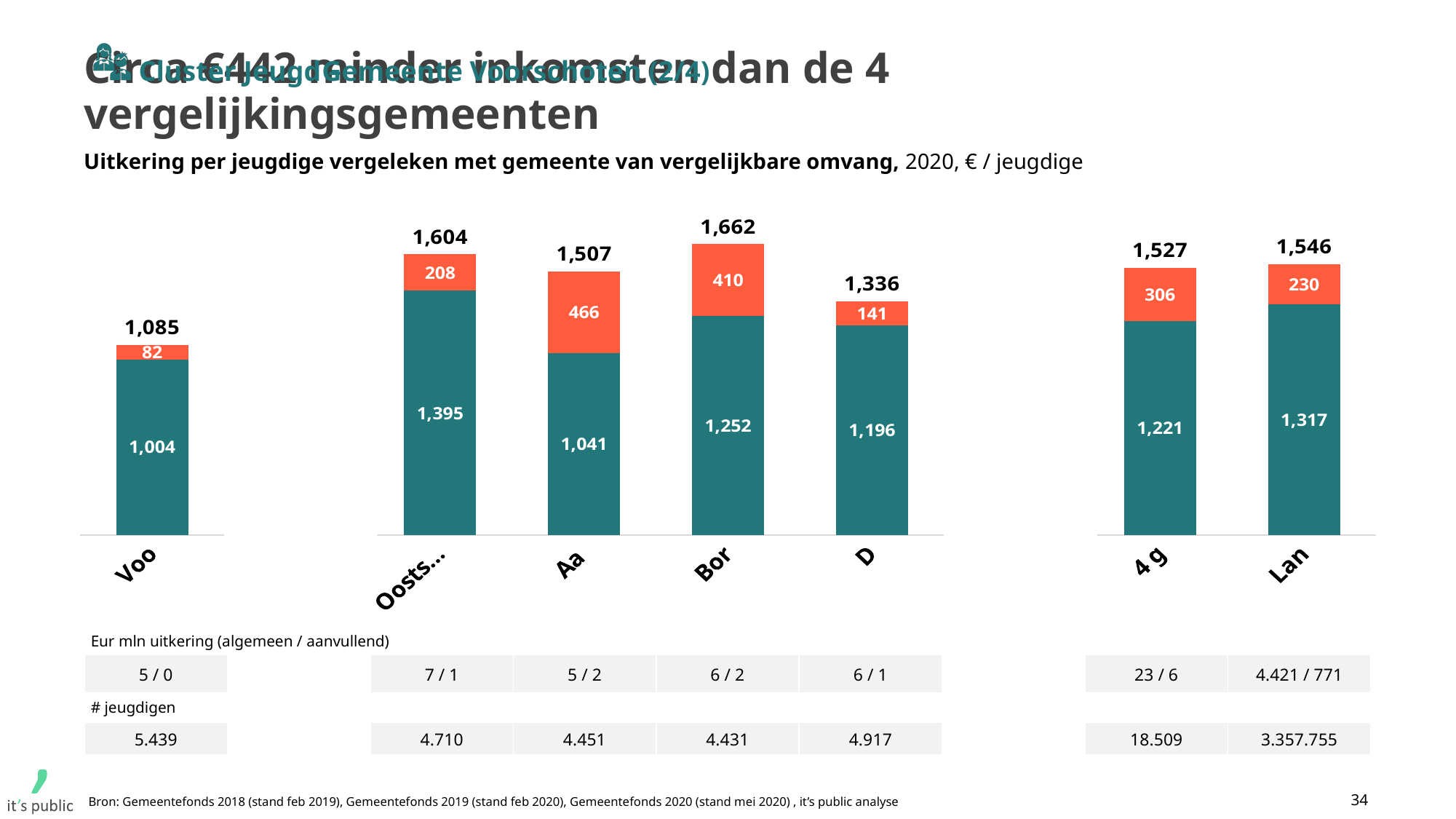
How many bars are shown in the chart? 7 What is the value of the orange (top) segment of the bar for 4 g? 306 What is the total value of the bar for Lan? 1,546 What is the difference between the total for Bor and the total for Voo? 577 What is the value of the orange (top) segment of the bar for Aa? 466 What is the value of the teal (bottom) segment of the bar for Bor? 1,252 Which category has the highest total bar value? Bor What is the total value of the bar for Voo? 1,085 Which category has the lowest total bar value? Voo Which is larger: the orange segment for Aa or the orange segment for Bor? Aa What kind of chart is shown on the slide? Stacked bar chart What is the sum of the two segments of the bar for D? 1,337